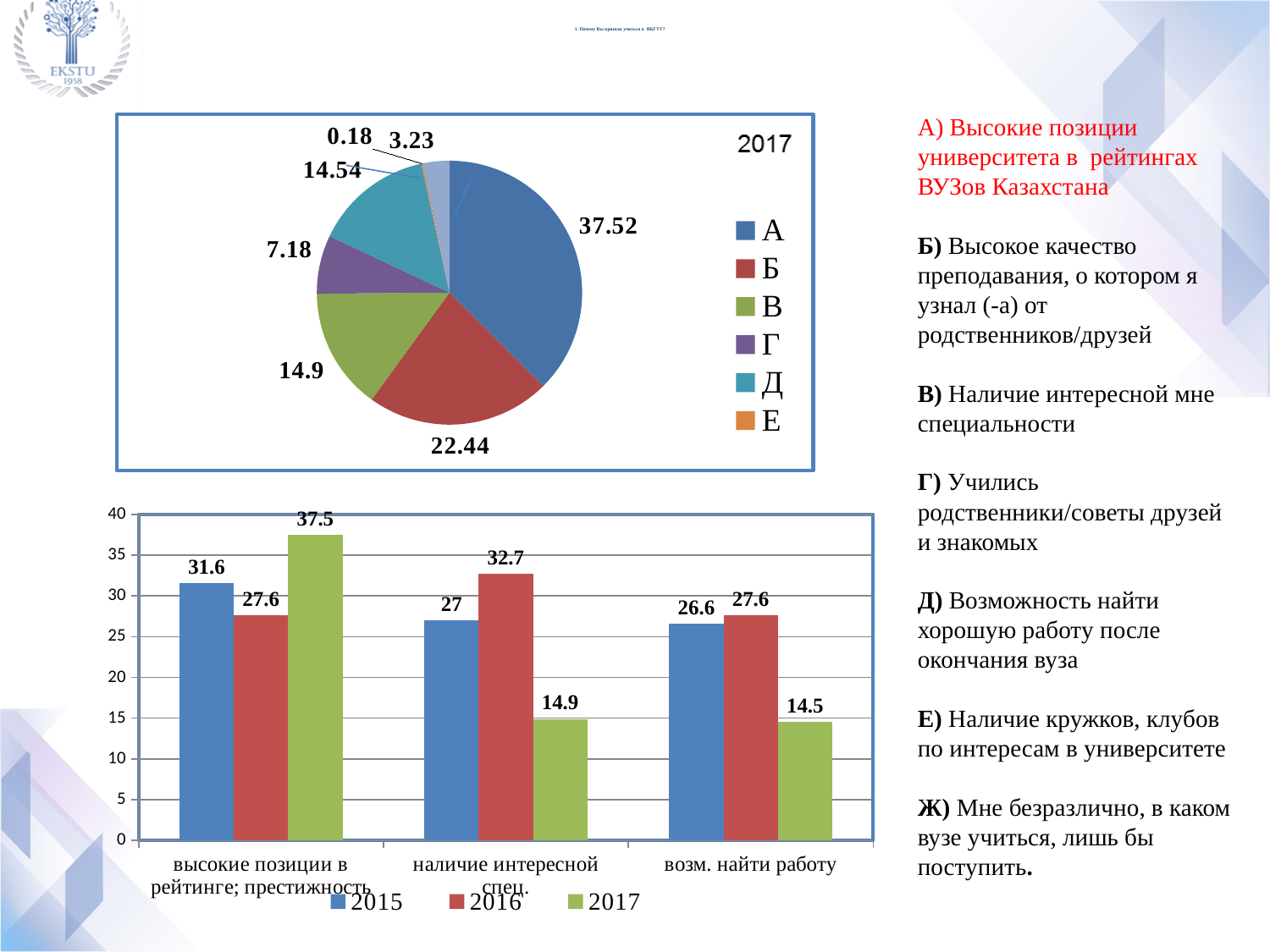
What type of chart is the bottom chart on the slide? bar chart In the pie chart titled 2017, which slice is the largest? А In the bottom bar chart, which is larger for 'наличие интересной спец.': the 2015 value or the 2016 value? 2016 In the pie chart titled 2017, how many entries does the legend list? 6 In the bottom bar chart, what is the 2015 value for 'возм. найти работу'? 26.6 In the bottom bar chart, what is the difference between the 2016 and 2017 values for 'возм. найти работу'? 13.1 In the bottom bar chart, what is the 2016 value for 'наличие интересной спец.'? 32.7 In the pie chart titled 2017, what is the difference between the values for А and Б? 15.08 In the pie chart titled 2017, what is the value for slice А? 37.52 In the bottom bar chart, what is the 2017 value for 'высокие позиции в рейтинге; престижность'? 37.5 In the pie chart titled 2017, what is the value for slice Б? 22.44 In the bottom bar chart, how many series does the legend list? 3